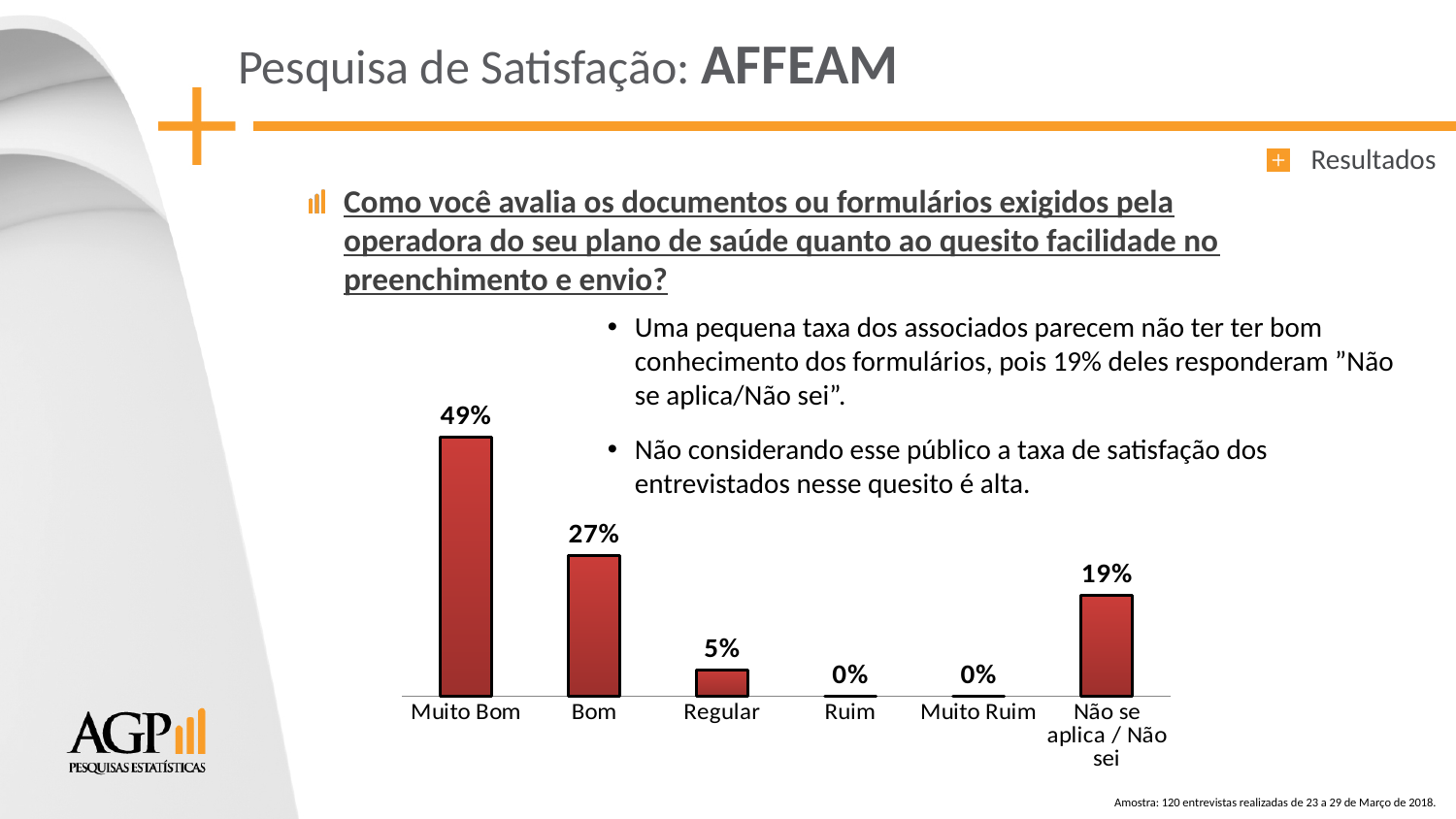
What kind of chart is shown on the slide? bar chart What is the difference between the values for Não se aplica / Não sei and Regular? 14% Which category has the highest value? Muito Bom What is the value for Bom? 27% What is the value for Regular? 5% What is the value for Muito Bom? 49% What is the value for Ruim? 0% What colour are the bars in the chart? red What is the difference between the values for Muito Bom and Bom? 22% How many categories are shown on the x axis? 6 What is the value for Não se aplica / Não sei? 19% Which is larger, the value for Bom or the value for Não se aplica / Não sei? Bom